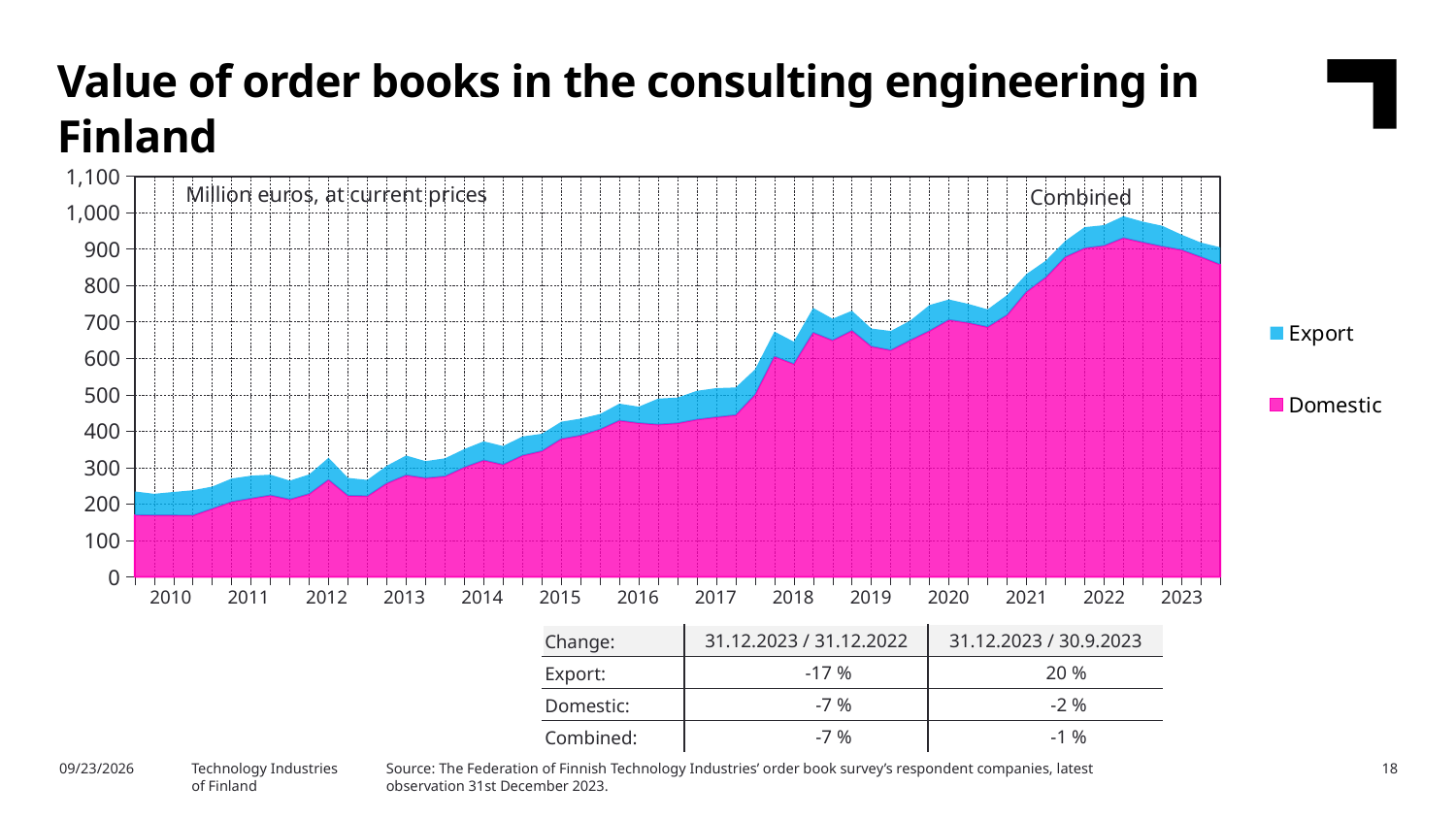
Which series is shown in pink (magenta) on the chart? Domestic What unit is the chart measured in, according to the label inside the plot area? Million euros, at current prices In which year does the combined value of order books reach its highest point? 2022 Is the Domestic value of order books in 2022 greater or less than 800? greater Which series is larger throughout the chart, Export or Domestic? Domestic Which two series are listed in the chart's legend? Export and Domestic Does the combined value of order books generally rise or fall from 2010 to 2022? rise What kind of chart is shown on the slide? Stacked area chart Is the Domestic value of order books at the start of 2010 greater or less than 200? less Is the combined value of order books at its 2022 peak greater or less than 900? greater How many series does the chart's legend list? 2